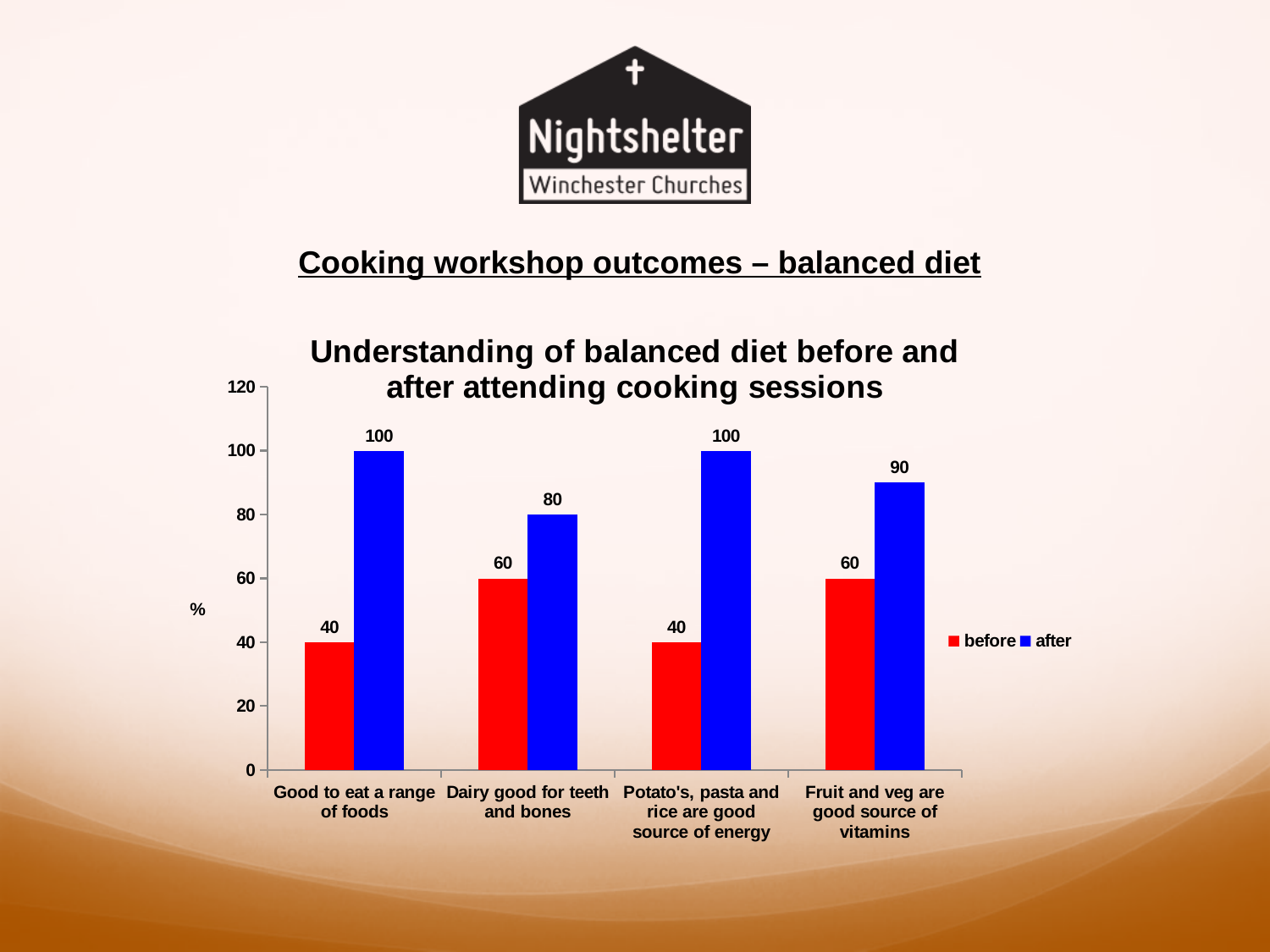
What is the difference between the 'after' and 'before' values for 'Potato's, pasta and rice are good source of energy'? 60 How many categories are shown on the x axis? 4 What is the 'after' value for 'Good to eat a range of foods'? 100 What kind of chart is shown on the slide? Bar chart Which colour represents the 'after' series? Blue What is the 'before' value for 'Dairy good for teeth and bones'? 60 Which is larger: the 'before' value for 'Dairy good for teeth and bones' or the 'before' value for 'Good to eat a range of foods'? Dairy good for teeth and bones What is the title of the chart? Understanding of balanced diet before and after attending cooking sessions Which category has the lowest 'after' value? Dairy good for teeth and bones What is the difference between the 'after' and 'before' values for 'Fruit and veg are good source of vitamins'? 30 What is the 'after' value for 'Fruit and veg are good source of vitamins'? 90 How many series does the legend list? 2